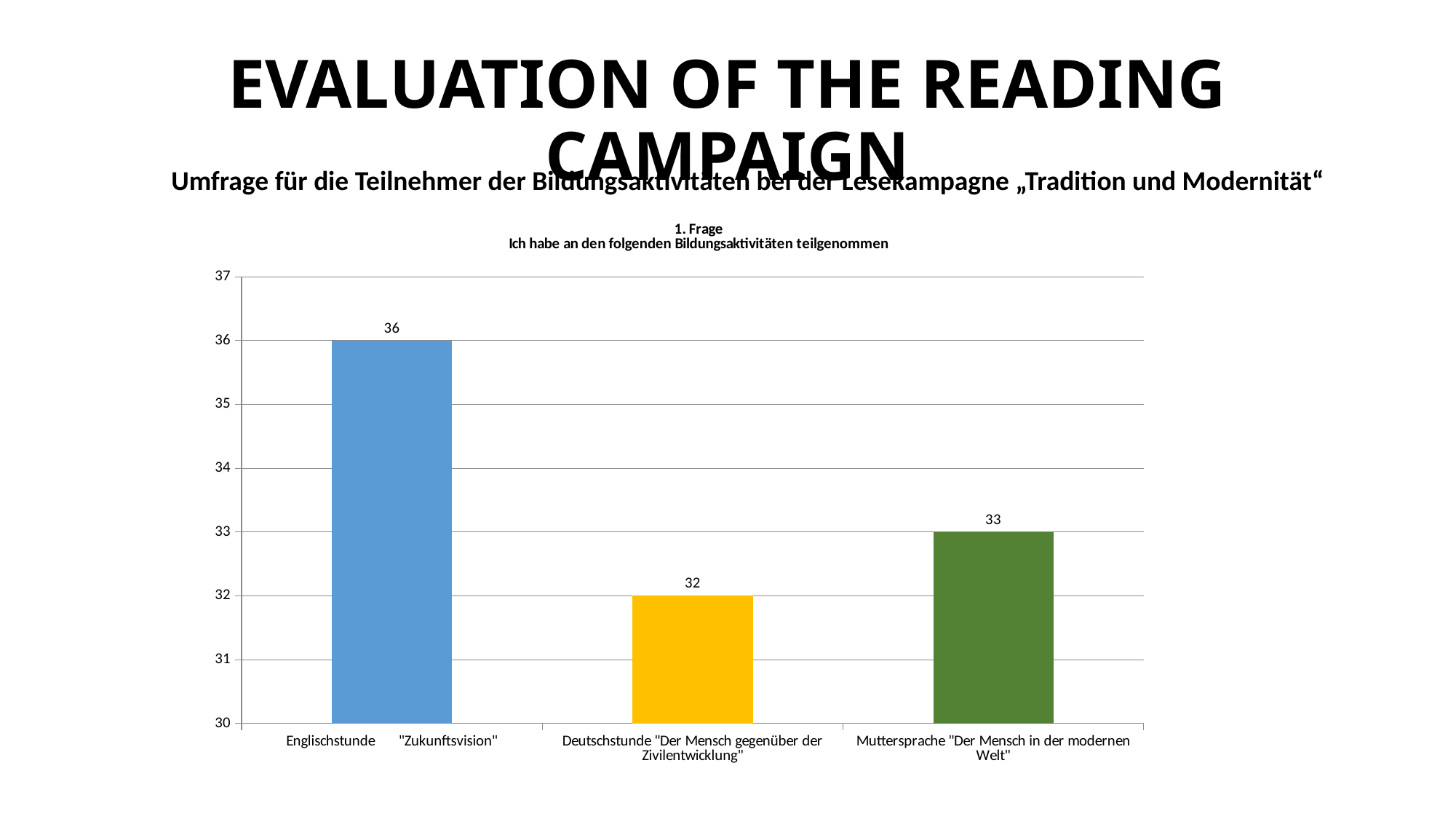
What is the difference between the values for Muttersprache "Der Mensch in der modernen Welt" and Deutschstunde "Der Mensch gegenüber der Zivilentwicklung"? 1 What is the value for Muttersprache "Der Mensch in der modernen Welt"? 33 Which is larger, the value for Englischstunde "Zukunftsvision" or the value for Muttersprache "Der Mensch in der modernen Welt"? Englischstunde "Zukunftsvision" Which category has the lowest value? Deutschstunde "Der Mensch gegenüber der Zivilentwicklung" What kind of chart is shown on the slide? bar chart What colour is the bar for Deutschstunde "Der Mensch gegenüber der Zivilentwicklung"? yellow Is the value for Deutschstunde "Der Mensch gegenüber der Zivilentwicklung" greater or less than 34? less How many categories are shown in the chart? 3 What is the value for Deutschstunde "Der Mensch gegenüber der Zivilentwicklung"? 32 What is the value for Englischstunde "Zukunftsvision"? 36 What is the difference between the values for Englischstunde "Zukunftsvision" and Deutschstunde "Der Mensch gegenüber der Zivilentwicklung"? 4 Which category has the highest value? Englischstunde "Zukunftsvision"